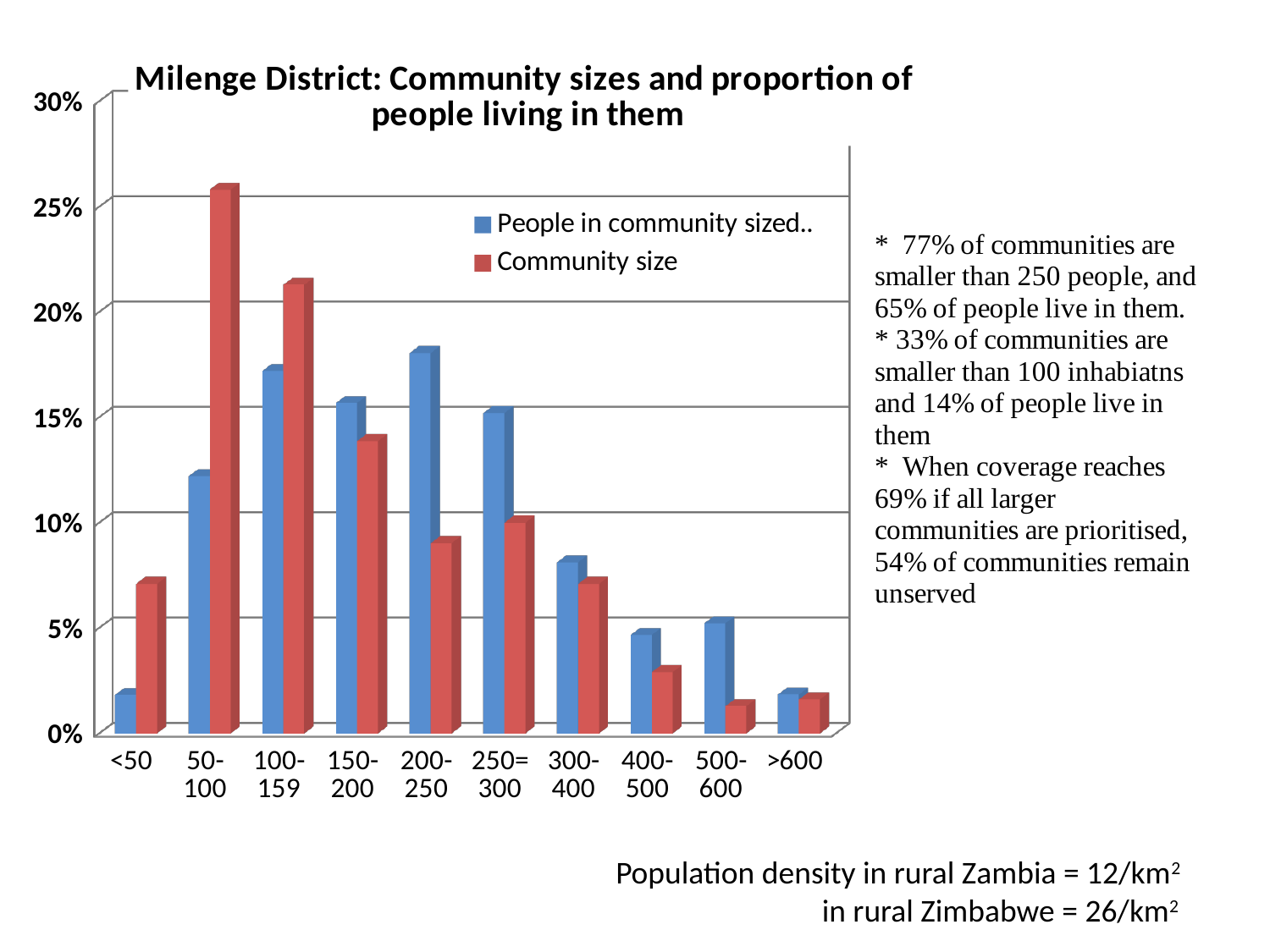
Is the Community size value for the 100-159 category greater or less than 20%? greater Is the Community size value for the 50-100 category greater or less than 25%? greater Which community size category has the highest value for the Community size series? 50-100 What colour are the bars for the Community size series? red How many community size categories are shown on the x axis? 10 Is the Community size value for the <50 category greater or less than 10%? less In the 50-100 category, which series has the larger value: People in community sized.. or Community size? Community size What kind of chart is shown on the slide? bar chart In the 200-250 category, which series has the larger value: People in community sized.. or Community size? People in community sized.. How many series does the legend list? 2